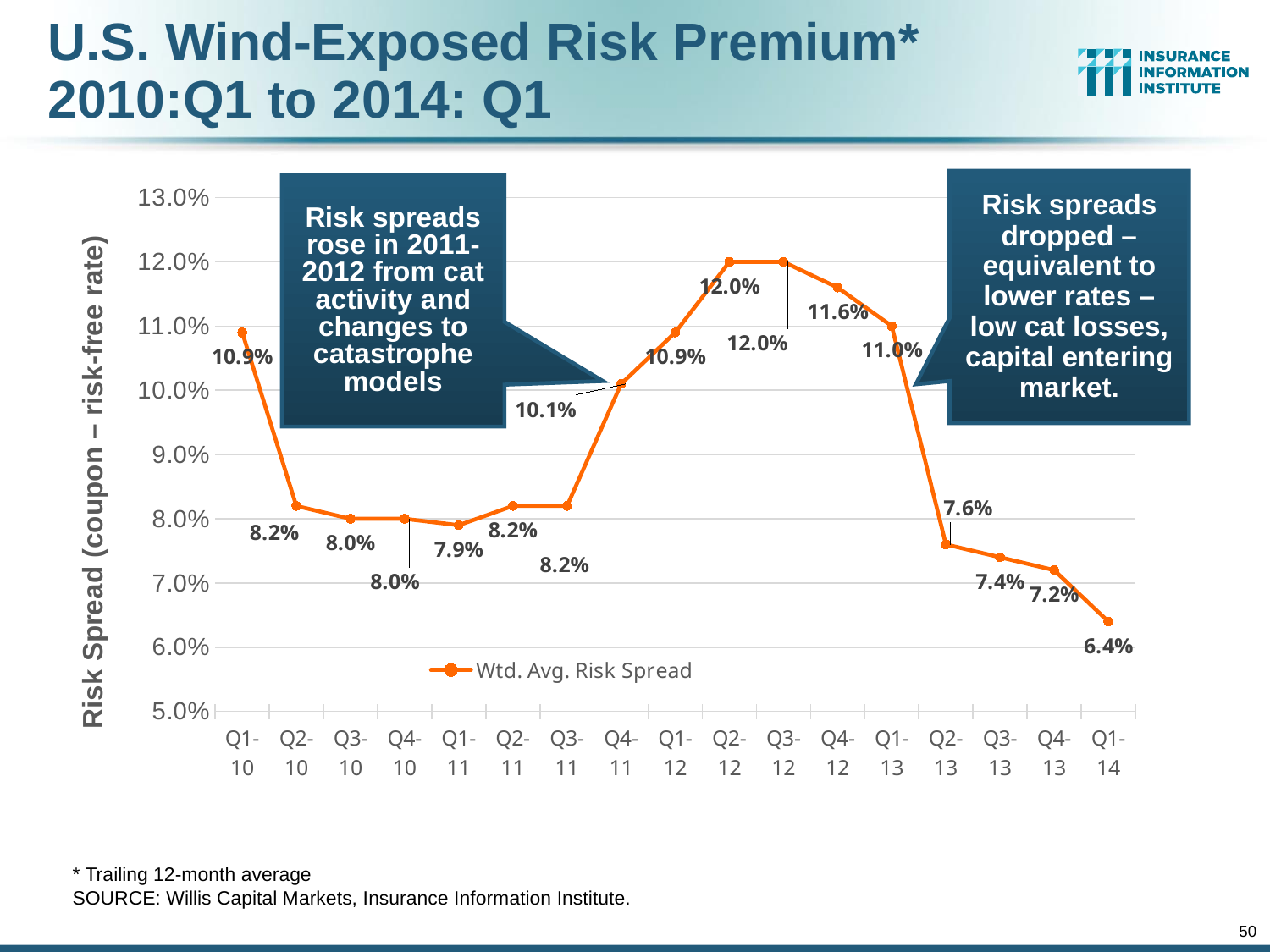
How many series does the legend list? 1 What is the weighted average risk spread for Q1-14? 6.4% Does the risk spread rise or fall from Q1-13 to Q1-14? fall Which quarter has the lowest weighted average risk spread? Q1-14 Which is larger, the risk spread in Q1-10 or in Q1-13? Q1-13 What is the weighted average risk spread for Q4-12? 11.6% What is the highest weighted average risk spread value shown on the chart? 12.0% What is the weighted average risk spread for Q4-11? 10.1% What type of chart is shown on the slide? line chart What is the difference between the risk spread in Q1-13 and Q2-13? 3.4% How many quarters are plotted on the x axis? 17 What is the weighted average risk spread for Q1-10? 10.9%